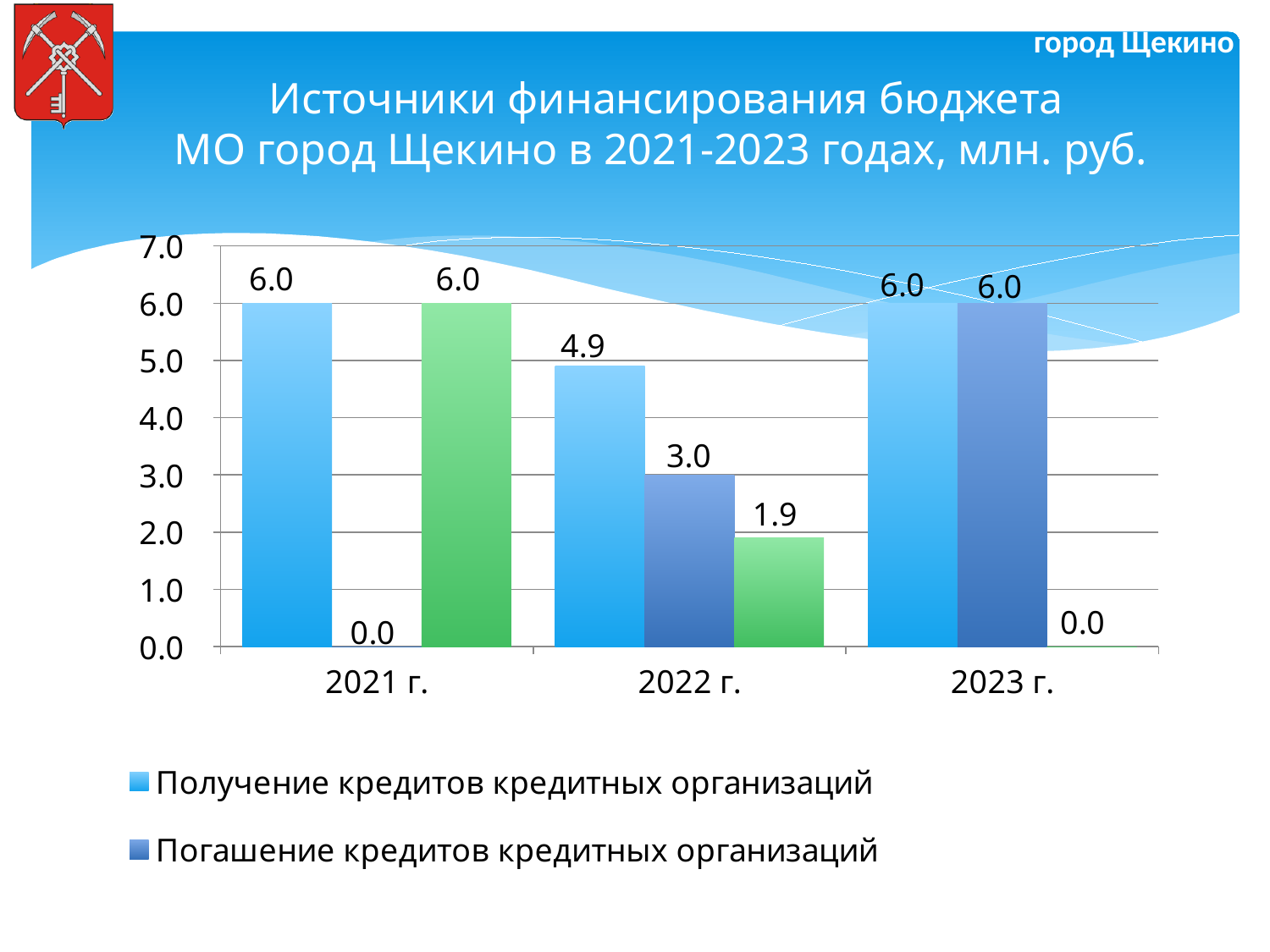
What is the value for Погашение кредитов кредитных организаций in 2021 г.? 0.0 Does Погашение кредитов кредитных организаций rise or fall from 2021 г. to 2023 г.? rise How many series does the legend list? 2 In 2022 г., which is larger: Получение кредитов кредитных организаций or Погашение кредитов кредитных организаций? Получение кредитов кредитных организаций What is the value for Получение кредитов кредитных организаций in 2022 г.? 4.9 In 2022 г., how much larger is Получение кредитов кредитных организаций than Погашение кредитов кредитных организаций? 1.9 What is the value for Погашение кредитов кредитных организаций in 2022 г.? 3.0 How many years are shown on the x axis? 3 What kind of chart is shown on the slide? bar chart What is the value for Получение кредитов кредитных организаций in 2021 г.? 6.0 What is the value for Погашение кредитов кредитных организаций in 2023 г.? 6.0 In which year is Получение кредитов кредитных организаций lowest? 2022 г.